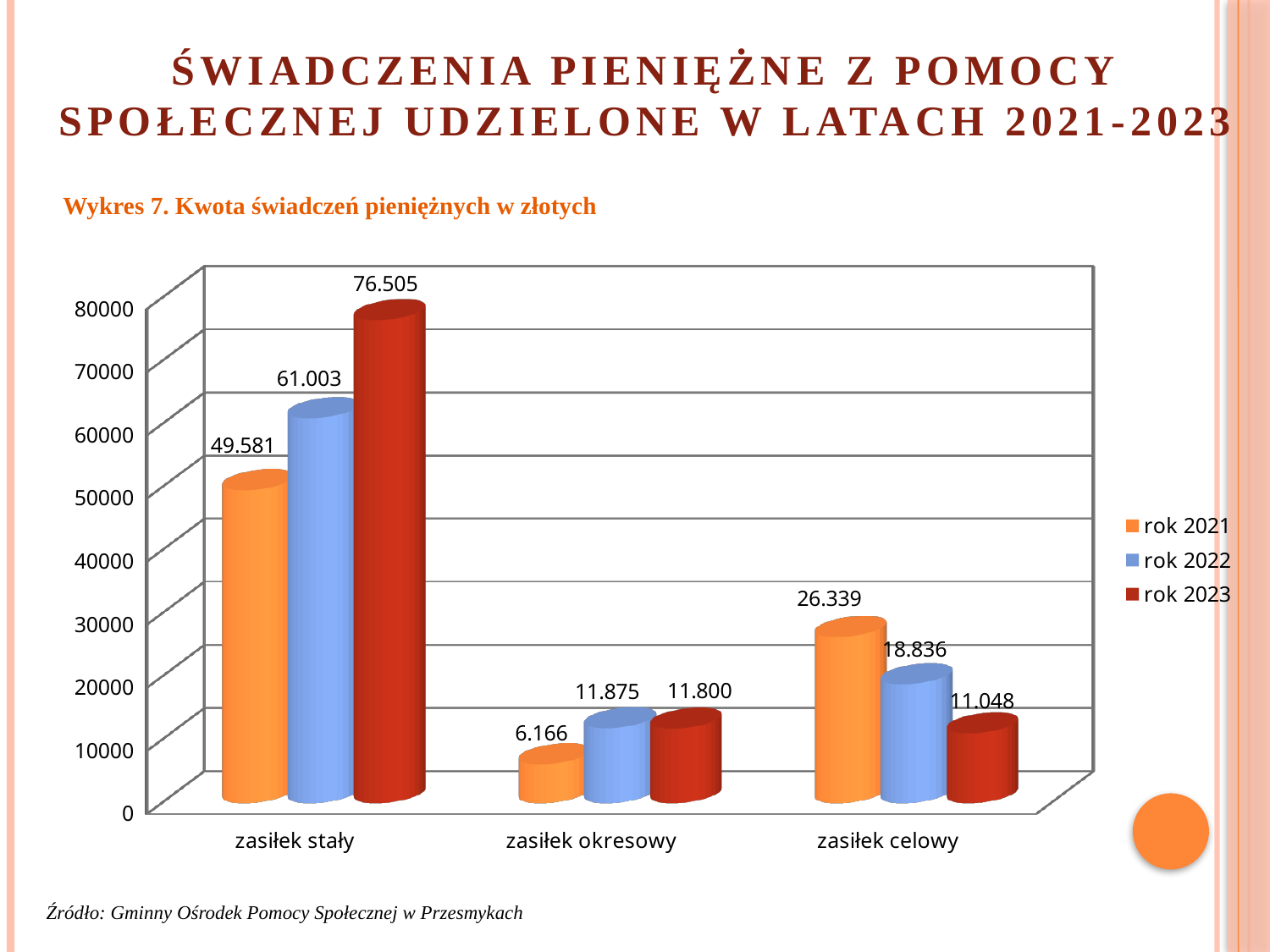
What is the value for zasiłek celowy in the rok 2022 series? 18.836 What is the difference between the rok 2023 and rok 2021 values for zasiłek stały? 26.924 What kind of chart is shown on the slide? bar chart How many categories are shown on the x axis? 3 What is the value for zasiłek stały in the rok 2023 series? 76.505 For zasiłek celowy, which is larger: the rok 2021 value or the rok 2023 value? rok 2021 Which category has the highest value in the rok 2021 series? zasiłek stały What is the value for zasiłek okresowy in the rok 2021 series? 6.166 What is the difference between the rok 2021 and rok 2023 values for zasiłek celowy? 15.291 Which category has the lowest value in the rok 2023 series? zasiłek celowy What is the title of the chart? Wykres 7. Kwota świadczeń pieniężnych w złotych How many series does the legend list? 3